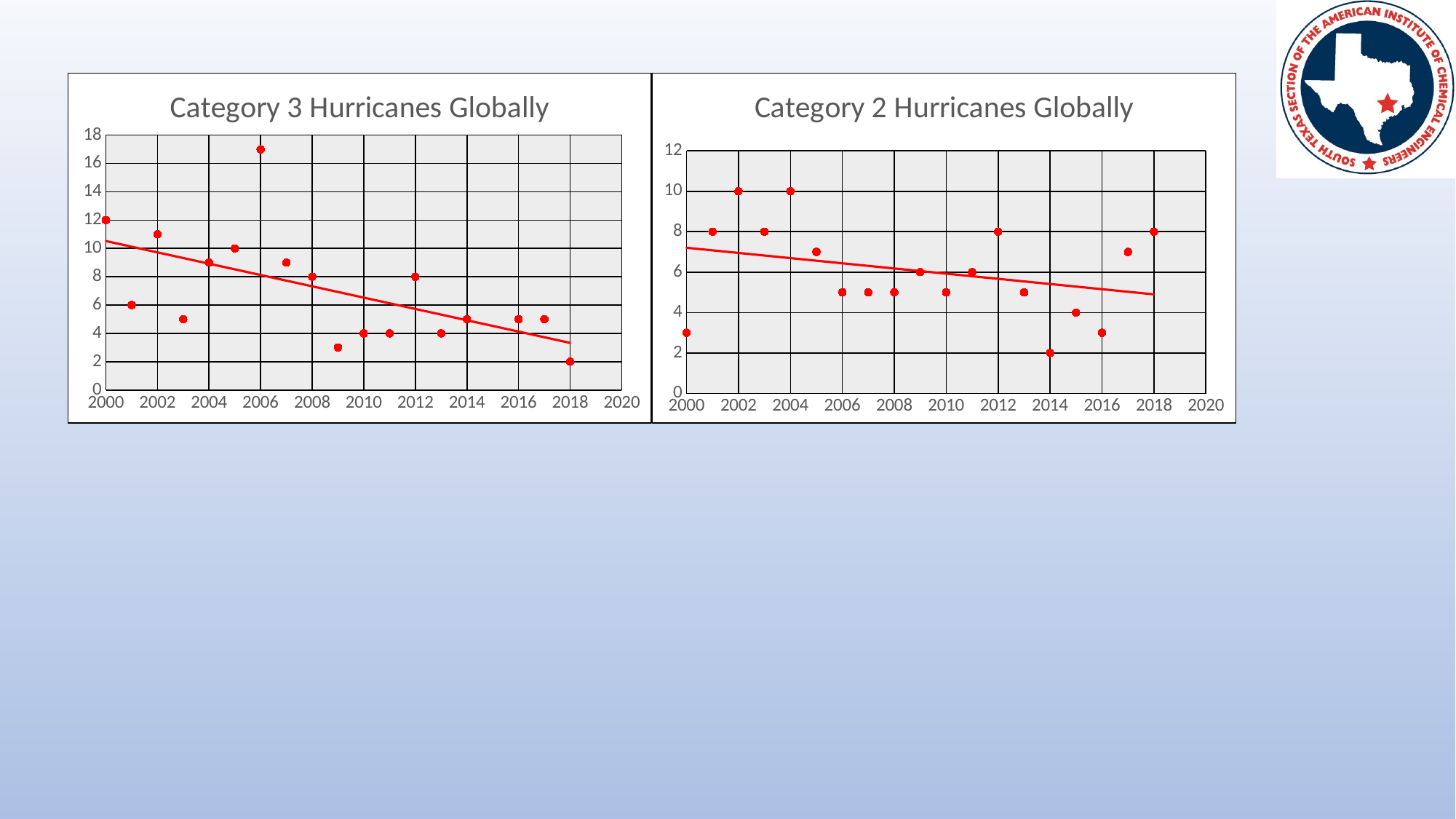
In the Category 3 Hurricanes Globally chart, which year has the lowest value? 2018 In the Category 3 Hurricanes Globally chart, what is the value for 2018? 2 In the Category 2 Hurricanes Globally chart, what is the value for 2014? 2 In the Category 2 Hurricanes Globally chart, what is the value for 2002? 10 In the Category 2 Hurricanes Globally chart, does the trend line rise or fall from 2000 to 2018? fall In the Category 2 Hurricanes Globally chart, which year has the lowest value? 2014 In the Category 3 Hurricanes Globally chart, what is the difference between the values for 2000 and 2018? 10 In the Category 3 Hurricanes Globally chart, which year has the highest value? 2006 What kind of chart is the Category 3 Hurricanes Globally chart? scatter chart In the Category 3 Hurricanes Globally chart, what is the value for 2000? 12 In the Category 3 Hurricanes Globally chart, is the value for 2006 greater or less than 16? greater In the Category 2 Hurricanes Globally chart, which is larger, the value for 2001 or the value for 2015? 2001